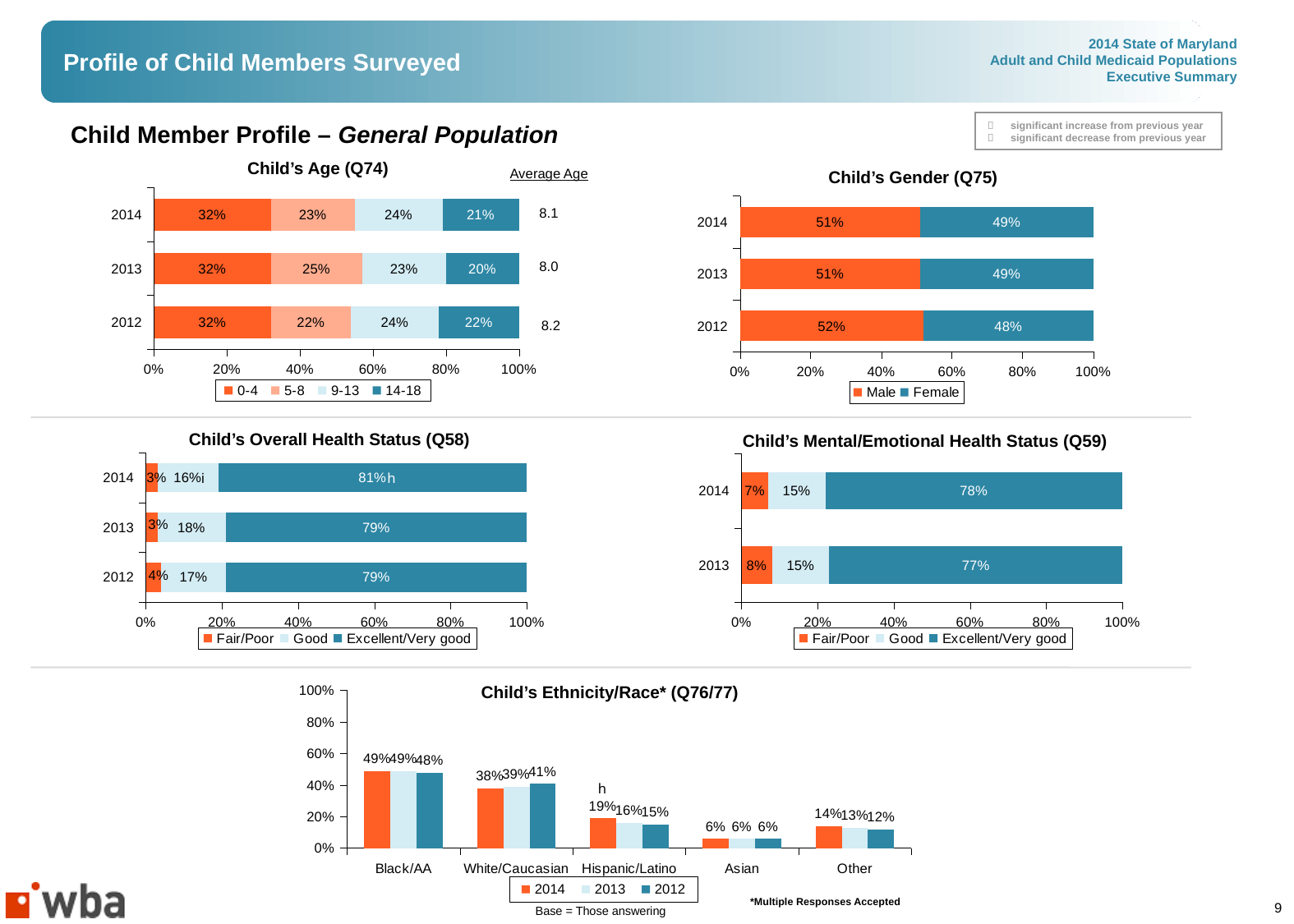
In the Child's Overall Health Status (Q58) chart, what percentage of children were rated Excellent/Very good in 2014? 81% In the Child's Age (Q74) chart, what percentage of children surveyed in 2014 were aged 0-4? 32% In the Child's Age (Q74) chart, how many series does the legend list? 4 In the Child's Age (Q74) chart, what is the difference between the 5-8 share in 2013 and the 5-8 share in 2012? 3 percentage points In the Child's Gender (Q75) chart, which is larger in 2014, the Male share or the Female share? Male In the Child's Mental/Emotional Health Status (Q59) chart, how many years are shown? 2 In the Child's Overall Health Status (Q58) chart, which year has the highest Good share? 2013 What kind of chart is the Child's Ethnicity/Race (Q76/77) chart? Bar chart In the Child's Mental/Emotional Health Status (Q59) chart, what is the Fair/Poor share for 2013? 8% In the Child's Ethnicity/Race (Q76/77) chart, which ethnicity category has the lowest values? Asian In the Child's Ethnicity/Race (Q76/77) chart, what is the 2012 value for White/Caucasian? 41% In the Child's Gender (Q75) chart, what percentage of children surveyed in 2012 were male? 52%